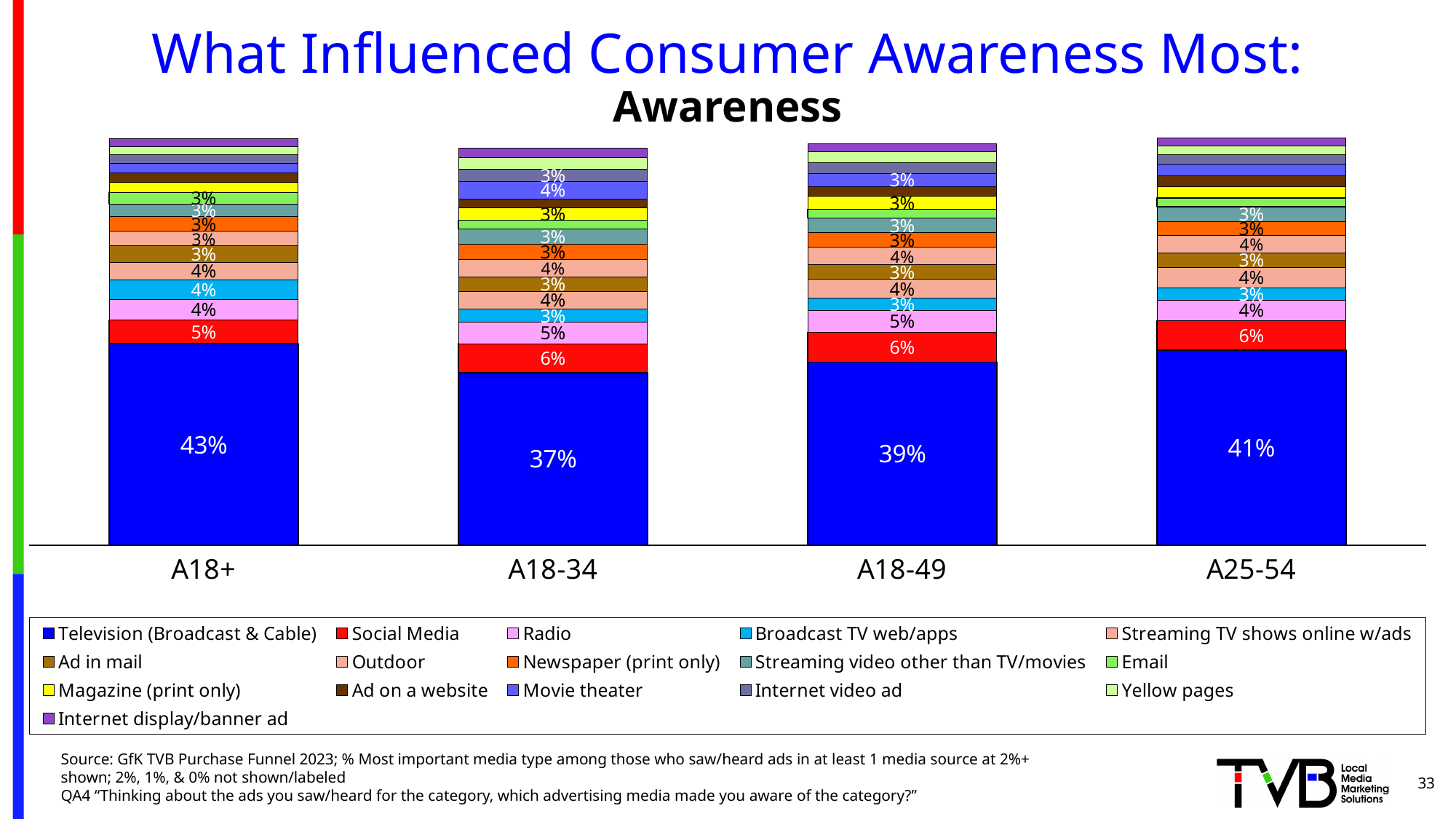
What is the Social Media value for A18+? 5% What is the Television (Broadcast & Cable) value for A18+? 43% Which age group has the highest Television (Broadcast & Cable) value? A18+ Which age group has the lowest Television (Broadcast & Cable) value? A18-34 Which is larger, the Television (Broadcast & Cable) value for A18-49 or for A25-54? A25-54 What kind of chart is shown on the slide? Stacked bar chart How many age groups are shown on the x axis? 4 What is the Television (Broadcast & Cable) value for A18-34? 37% What is the difference between the Television (Broadcast & Cable) values for A18+ and A18-34? 6% What is the Radio value for A18-34? 5% How many series does the legend list? 16 What is the Social Media value for A18-49? 6%